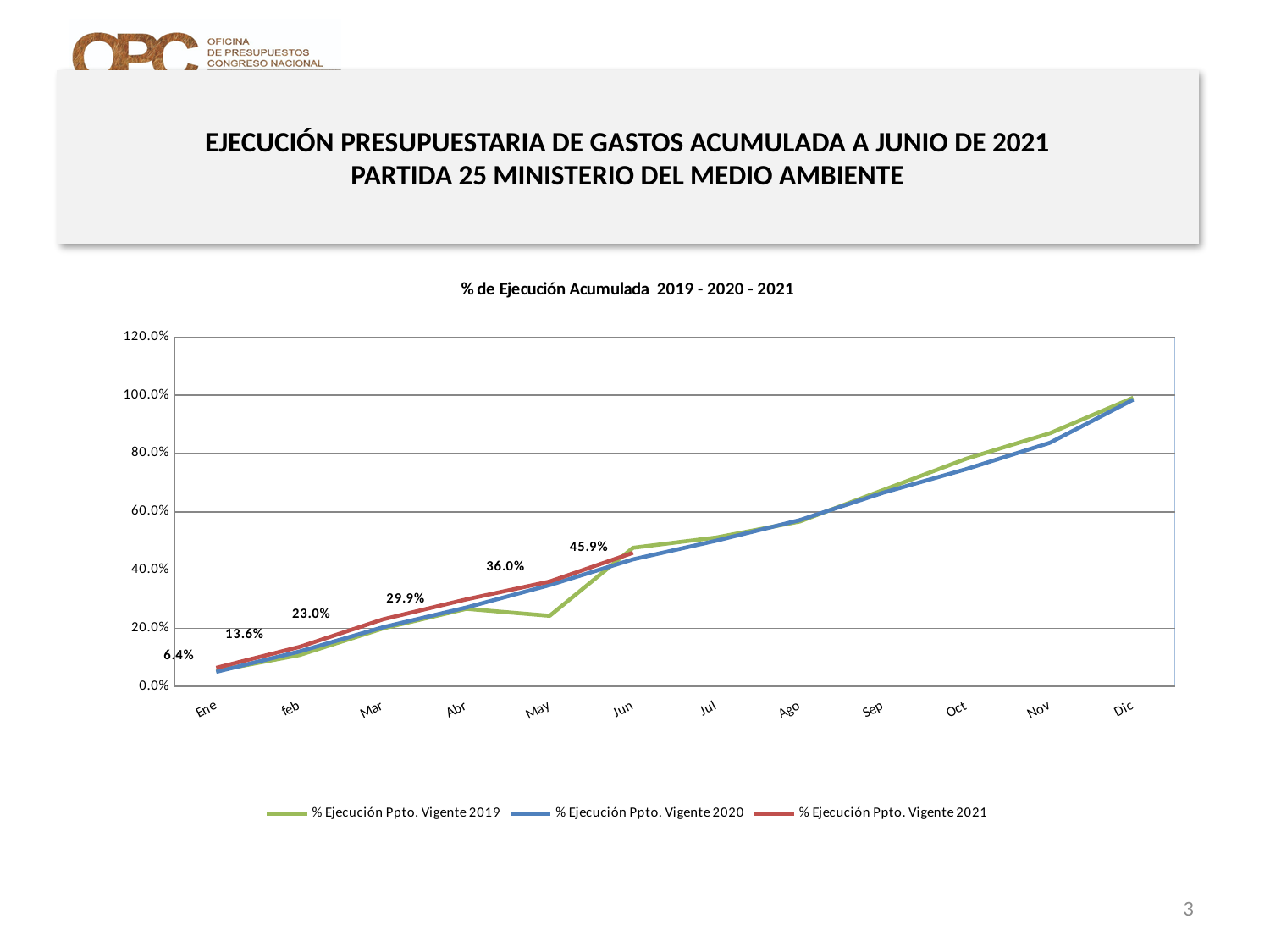
How many months are shown on the x axis? 12 What is the value for % Ejecución Ppto. Vigente 2021 in Abr? 29.9% What is the value for % Ejecución Ppto. Vigente 2021 in Ene? 6.4% Does the % Ejecución Ppto. Vigente 2021 series rise or fall from Ene to Jun? rise What is the title of the chart? % de Ejecución Acumulada 2019 - 2020 - 2021 What is the difference between the 2021 values for Jun and May? 9.9% What is the value for % Ejecución Ppto. Vigente 2021 in Mar? 23.0% How many series does the legend list? 3 What is the value for % Ejecución Ppto. Vigente 2021 in Jun? 45.9% What is the value for % Ejecución Ppto. Vigente 2021 in Feb? 13.6% Is the value for % Ejecución Ppto. Vigente 2019 in May greater or less than 40.0%? less What kind of chart is shown on the slide? line chart